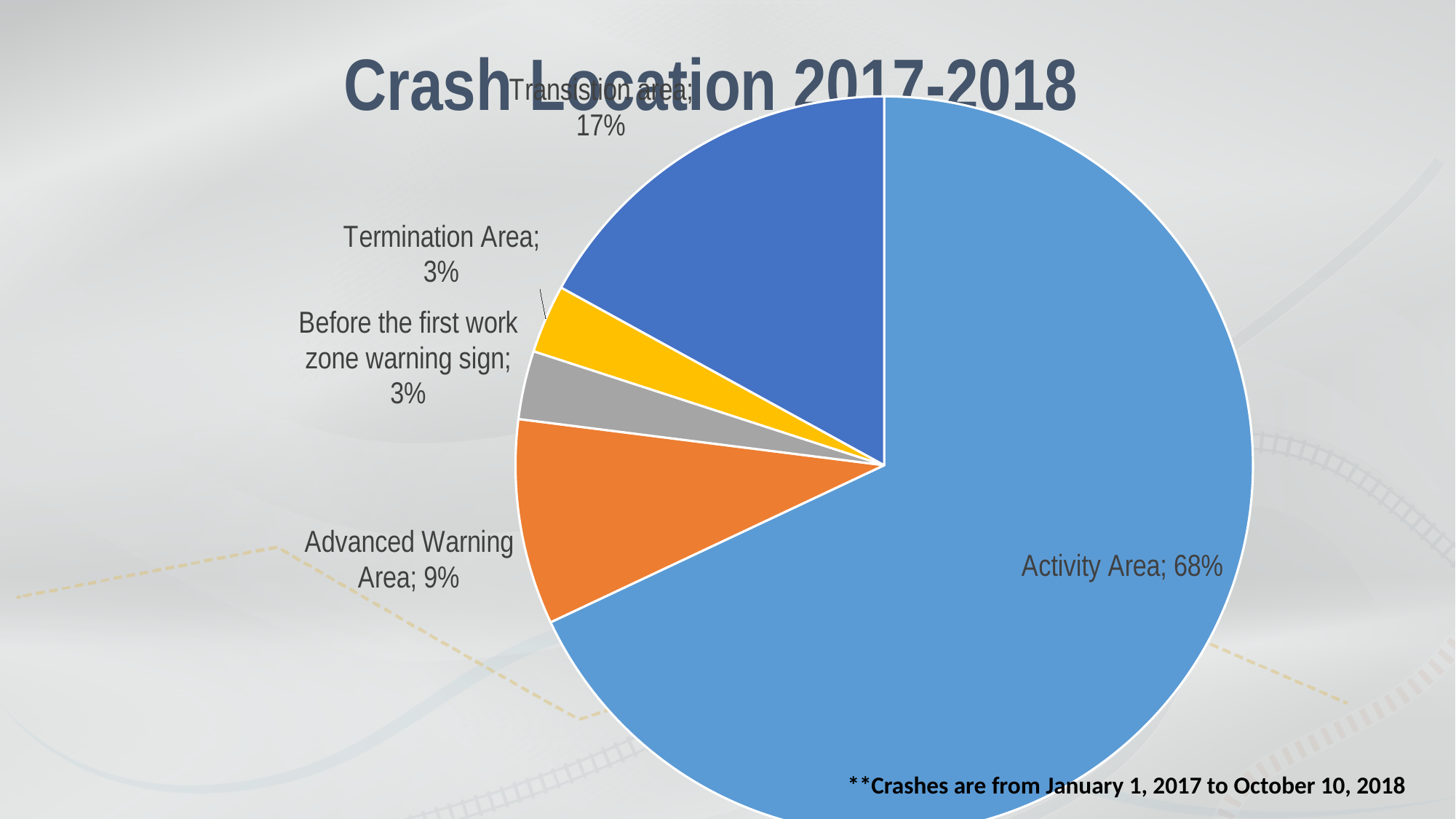
Which crash location has the largest share of crashes? Activity Area What percentage of crashes occurred before the first work zone warning sign? 3% According to the note on the slide, what date range do the crashes cover? January 1, 2017 to October 10, 2018 What percentage of crashes occurred in the Termination Area? 3% What is the difference in percentage points between the Activity Area and the Transition area? 51 percentage points What share of crashes occurred in the Activity Area? 68% What is the title of the chart? Crash Location 2017-2018 What percentage of crashes occurred in the Advanced Warning Area? 9% Which has a larger share of crashes, the Advanced Warning Area or the Transition area? Transition area What percentage of crashes occurred in the Transition area? 17% How many slices does the pie chart have? 5 What type of chart is shown on the slide? Pie chart